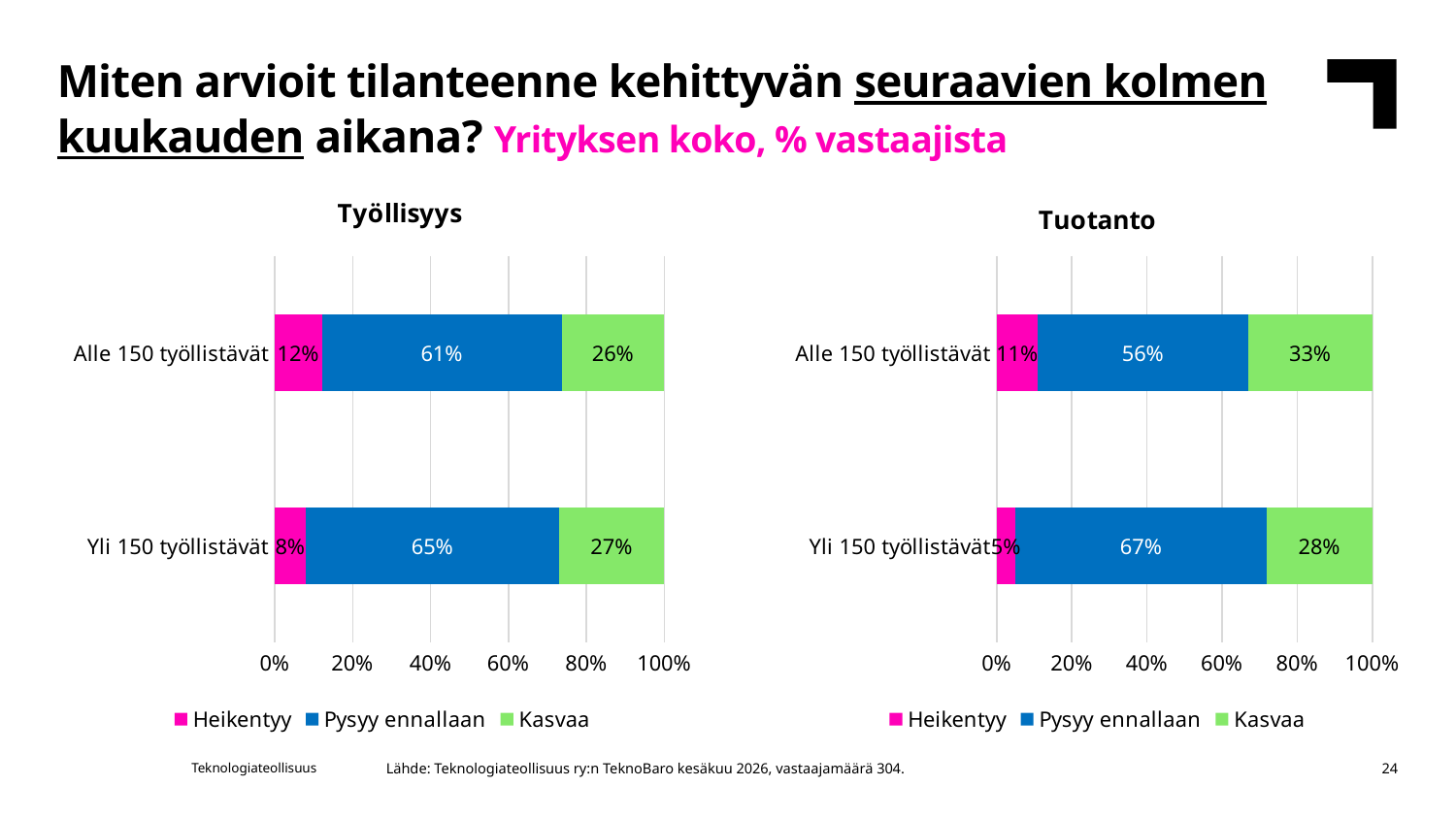
In the Tuotanto chart, what is the value of Heikentyy for Yli 150 työllistävät? 5% In the Tuotanto chart, what is the value of Kasvaa for Alle 150 työllistävät? 33% In the Tuotanto chart, what is the difference between the Heikentyy values for Alle 150 työllistävät and Yli 150 työllistävät? 6 percentage points In the Tuotanto chart, which category has the higher Kasvaa value, Alle 150 työllistävät or Yli 150 työllistävät? Alle 150 työllistävät In the Työllisyys chart, what is the value of Heikentyy for Yli 150 työllistävät? 8% In the Työllisyys chart, which category has the higher Heikentyy value? Alle 150 työllistävät In the Työllisyys chart, what is the difference between the Pysyy ennallaan values for Yli 150 työllistävät and Alle 150 työllistävät? 4 percentage points In the Työllisyys chart, what is the value of Pysyy ennallaan for Alle 150 työllistävät? 61% What kind of chart is the Tuotanto chart? Stacked bar chart How many categories are shown in the Työllisyys chart? 2 How many series does the legend of the Tuotanto chart list? 3 In the Tuotanto chart, what is the value of Pysyy ennallaan for Yli 150 työllistävät? 67%